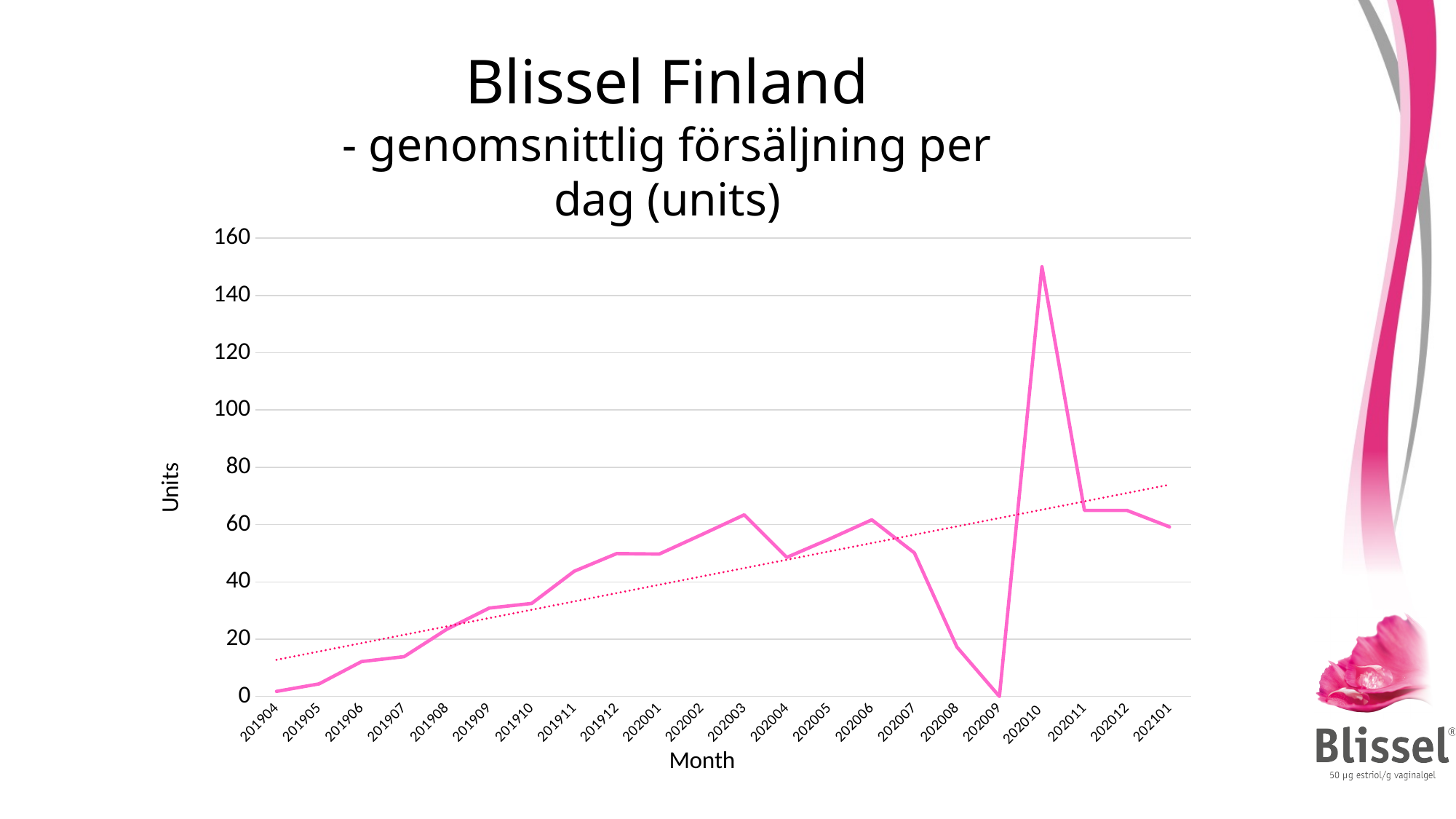
Which month has the highest value? 202010 What is the label of the y axis? Units Which is larger, the value for 202003 or the value for 202004? 202003 Is the value for 202004 greater or less than 60? less Which month has the lowest value? 202009 Is the value for 201909 greater or less than 20? greater Is the value for 202010 greater or less than 140? greater What kind of chart is shown on the slide? line chart How many months are plotted along the x axis? 22 What is the value for 202009? 0 Do the values rise or fall from 201904 to 202003? rise